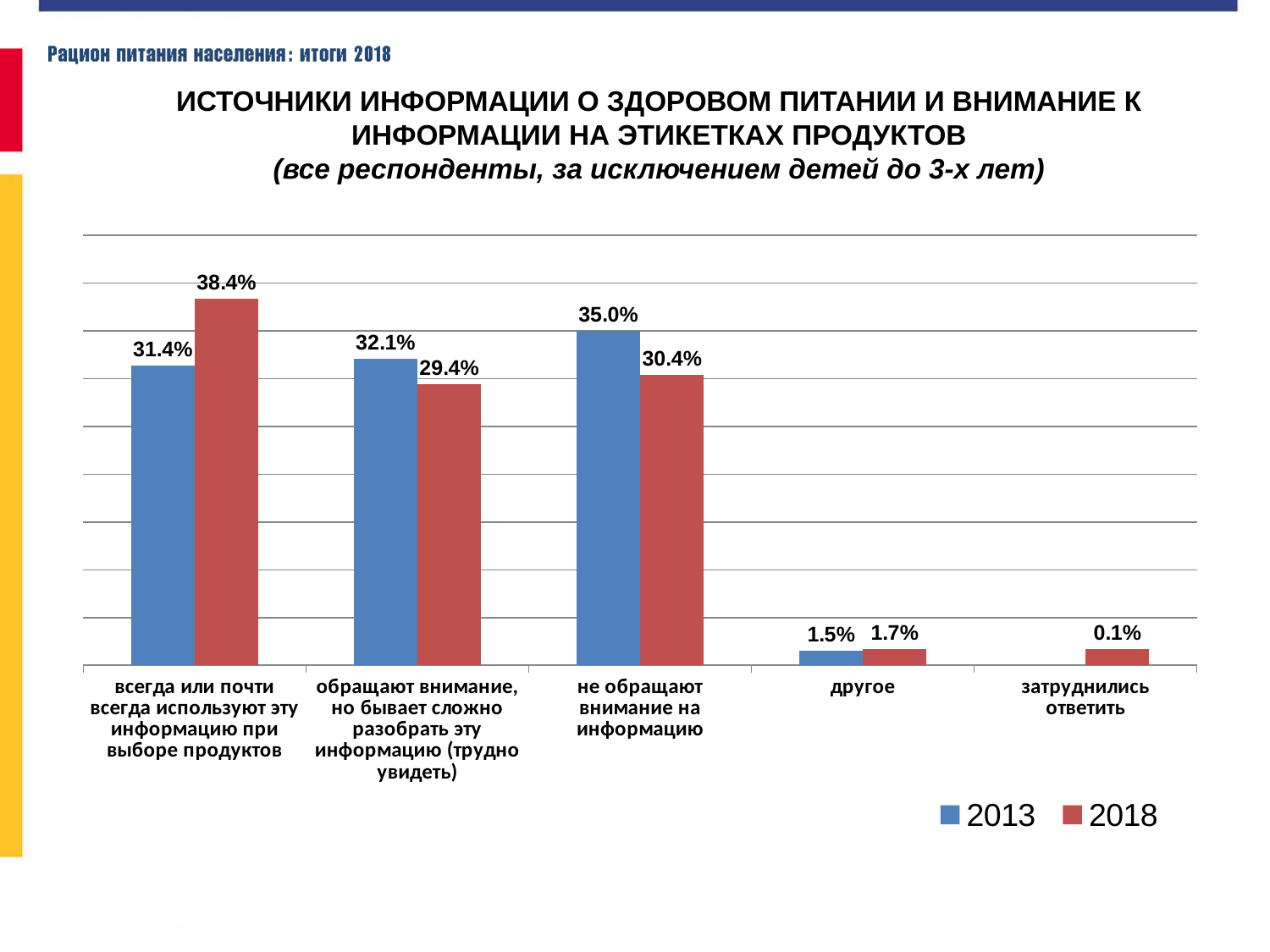
How many categories are shown on the x axis? 5 What is the difference between the 2018 and 2013 values for «всегда или почти всегда используют эту информацию при выборе продуктов»? 7.0% How many series does the legend list? 2 What is the 2018 value for «затруднились ответить»? 0.1% Which category has the lowest 2018 value? затруднились ответить Which series is shown in red in the legend? 2018 What is the 2018 value for «всегда или почти всегда используют эту информацию при выборе продуктов»? 38.4% What is the 2018 value for «обращают внимание, но бывает сложно разобрать эту информацию (трудно увидеть)»? 29.4% For «не обращают внимание на информацию», which year has the larger value, 2013 or 2018? 2013 What is the 2013 value for «не обращают внимание на информацию»? 35.0% What kind of chart is shown on the slide? bar chart Which category has the highest 2013 value? не обращают внимание на информацию